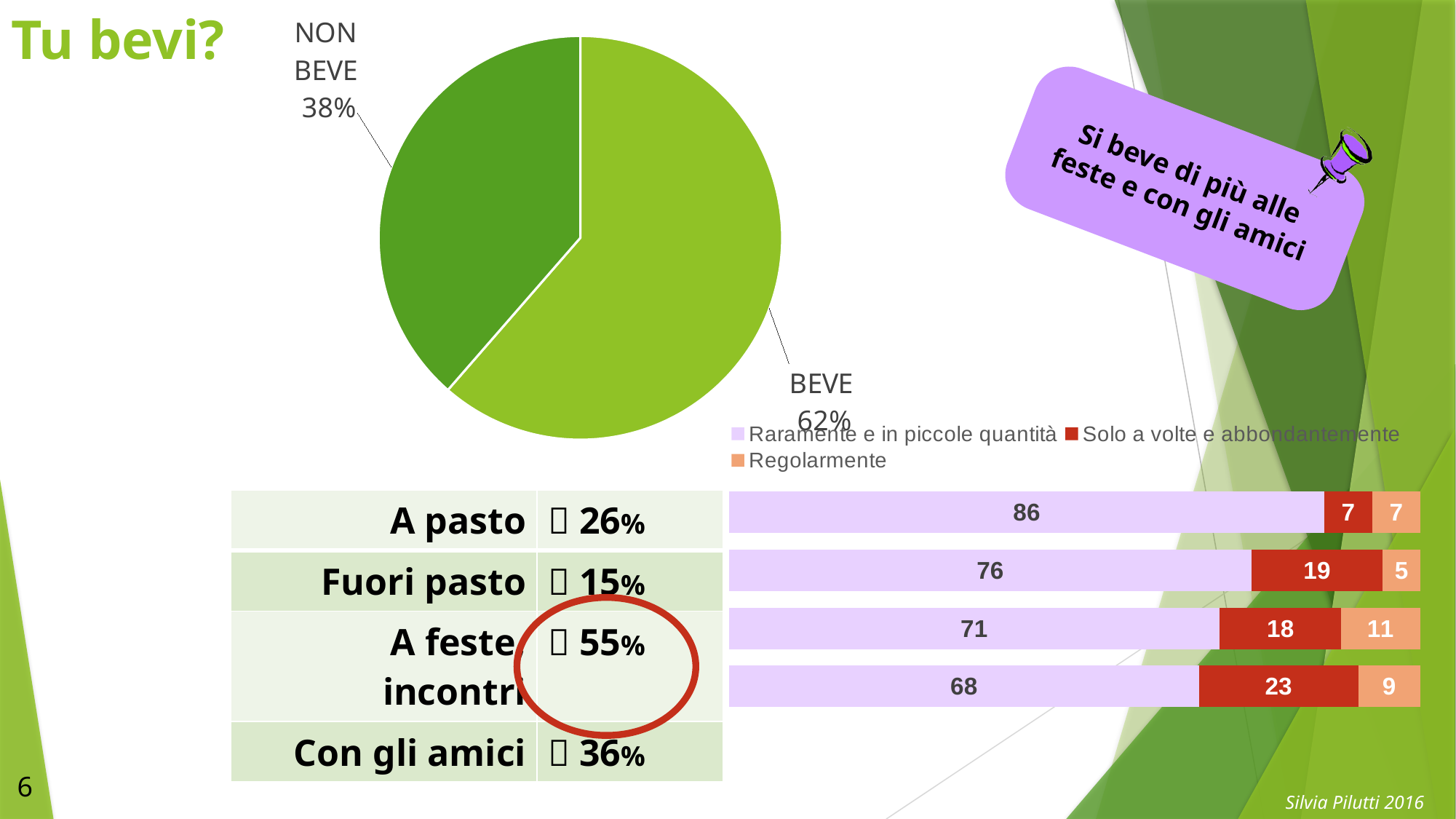
How many series does the legend of the stacked bar chart list? 3 In the stacked bar chart, what is the value of the 'Solo a volte e abbondantemente' segment in the bottom bar? 23 In the stacked bar chart, what is the value of the 'Regolarmente' segment in the third bar from the top? 11 How many bars are there in the stacked bar chart? 4 In the pie chart, which slice is larger, BEVE or NON BEVE? BEVE What kind of chart is the chart at the top of the slide with the BEVE and NON BEVE slices? pie chart In the stacked bar chart, what is the value of the 'Raramente e in piccole quantità' segment in the top bar? 86 In the pie chart, what percentage is shown for NON BEVE? 38% In the pie chart, what percentage is shown for BEVE? 62% What kind of chart is the chart at the bottom right of the slide with the purple, red and orange segments? bar chart How many slices does the pie chart have? 2 In the stacked bar chart, what is the total of the second bar from the top (76, 19 and 5)? 100